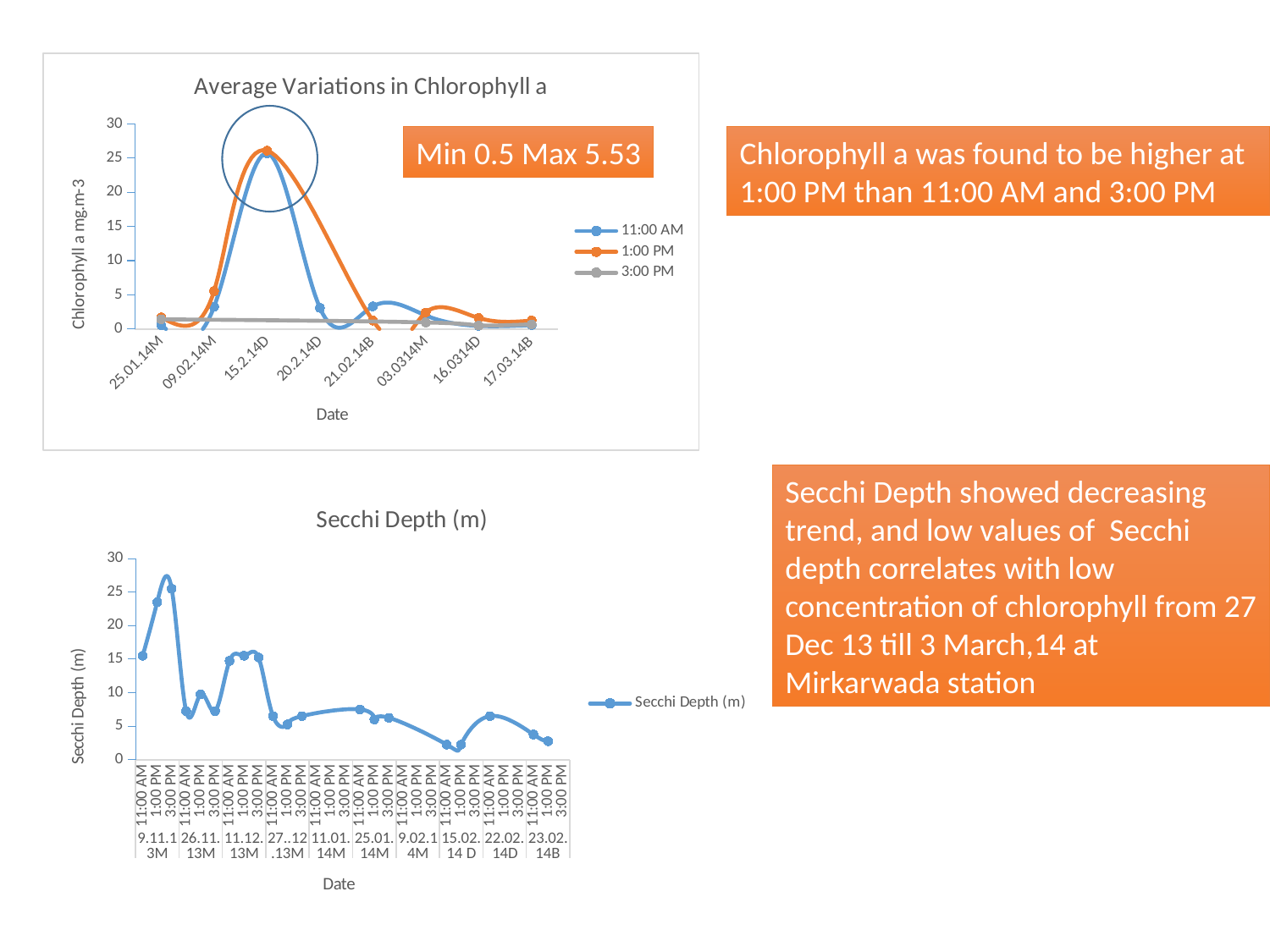
What kind of chart is the 'Secchi Depth (m)' chart? line chart What kind of chart is the 'Average Variations in Chlorophyll a' chart? line chart How many dates are shown on the x axis of the 'Average Variations in Chlorophyll a' chart? 8 How many series does the legend of the 'Average Variations in Chlorophyll a' chart list? 3 What are the legend entries of the 'Average Variations in Chlorophyll a' chart? 11:00 AM, 1:00 PM, 3:00 PM In the 'Average Variations in Chlorophyll a' chart, is the 1:00 PM value on 15.2.14D greater or less than 20? greater How many series does the legend of the 'Secchi Depth (m)' chart list? 1 In the 'Average Variations in Chlorophyll a' chart, on which date does the 1:00 PM series reach its highest value? 15.2.14D In the 'Secchi Depth (m)' chart, do the values overall rise or fall from left to right along the x axis? fall